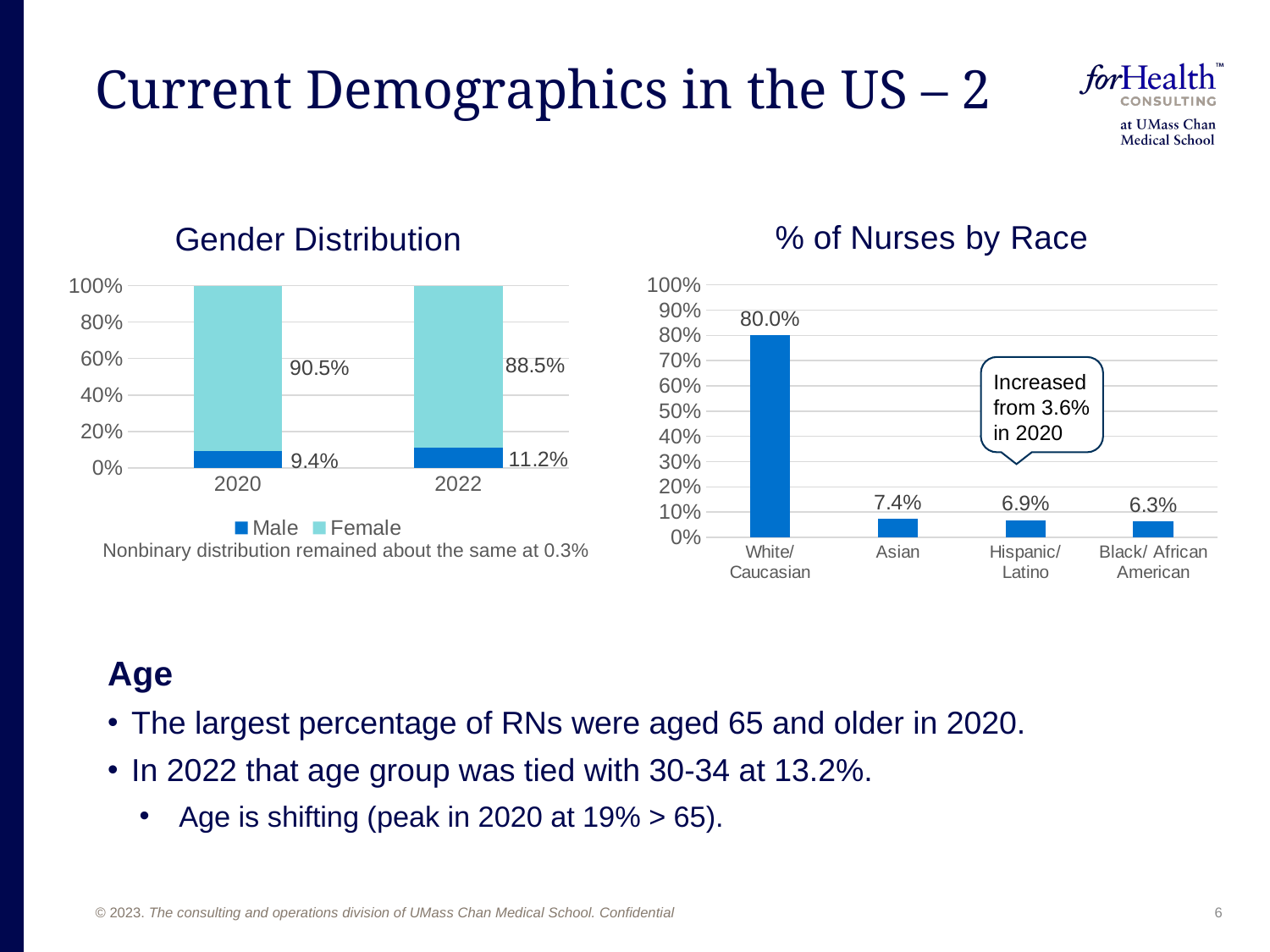
What kind of chart is the % of Nurses by Race chart? bar chart In the % of Nurses by Race chart, what is the difference between the Asian and Black/African American values? 1.1% In the Gender Distribution chart, does the Female share rise or fall from 2020 to 2022? fall In the Gender Distribution chart, how many series does the legend list? 2 In the % of Nurses by Race chart, which category has the highest value? White/ Caucasian In the Gender Distribution chart, what is the difference between the Male values for 2022 and 2020? 1.8% In the Gender Distribution chart, what is the Female value for 2020? 90.5% In the % of Nurses by Race chart, which category has the lowest value? Black/ African American In the Gender Distribution chart, what is the Male value for 2022? 11.2% In the % of Nurses by Race chart, what is the value for Hispanic/Latino? 6.9% In the % of Nurses by Race chart, how many categories are shown? 4 In the % of Nurses by Race chart, what is the value for White/Caucasian? 80.0%